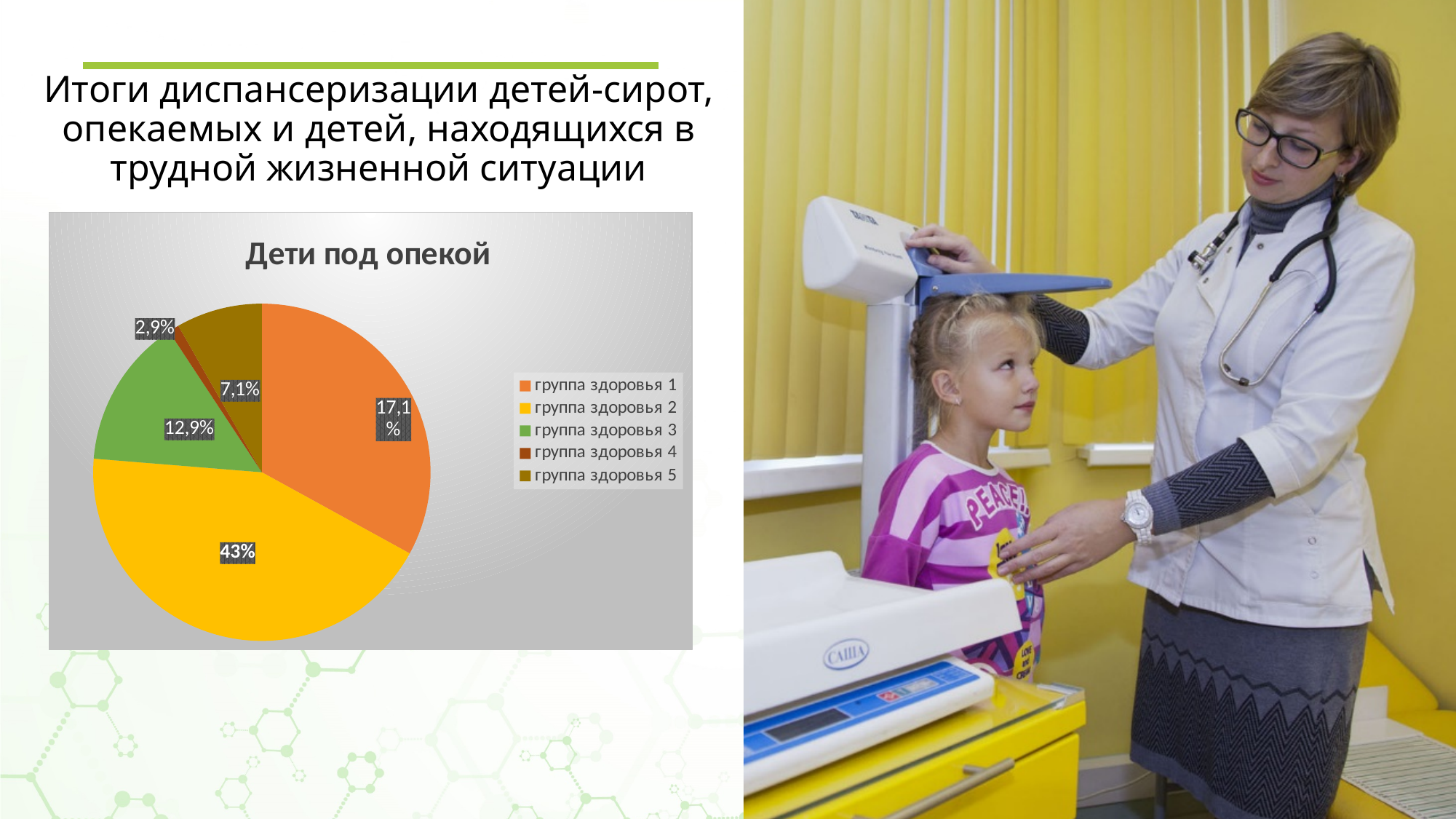
How many entries does the legend list? 5 What kind of chart is shown on the slide? pie chart What is the value shown for группа здоровья 3? 12,9% How many slices does the pie chart have? 5 What is the title of the chart? Дети под опекой What colour represents группа здоровья 2 in the chart? yellow What is the value shown for группа здоровья 5? 7,1% Which is larger, the value for группа здоровья 3 or группа здоровья 5? группа здоровья 3 Which health group has the smallest share of the pie? группа здоровья 4 Which health group has the largest share of the pie? группа здоровья 2 What is the difference between the values for группа здоровья 2 and группа здоровья 1? 25,9% What is the value shown for группа здоровья 2? 43%